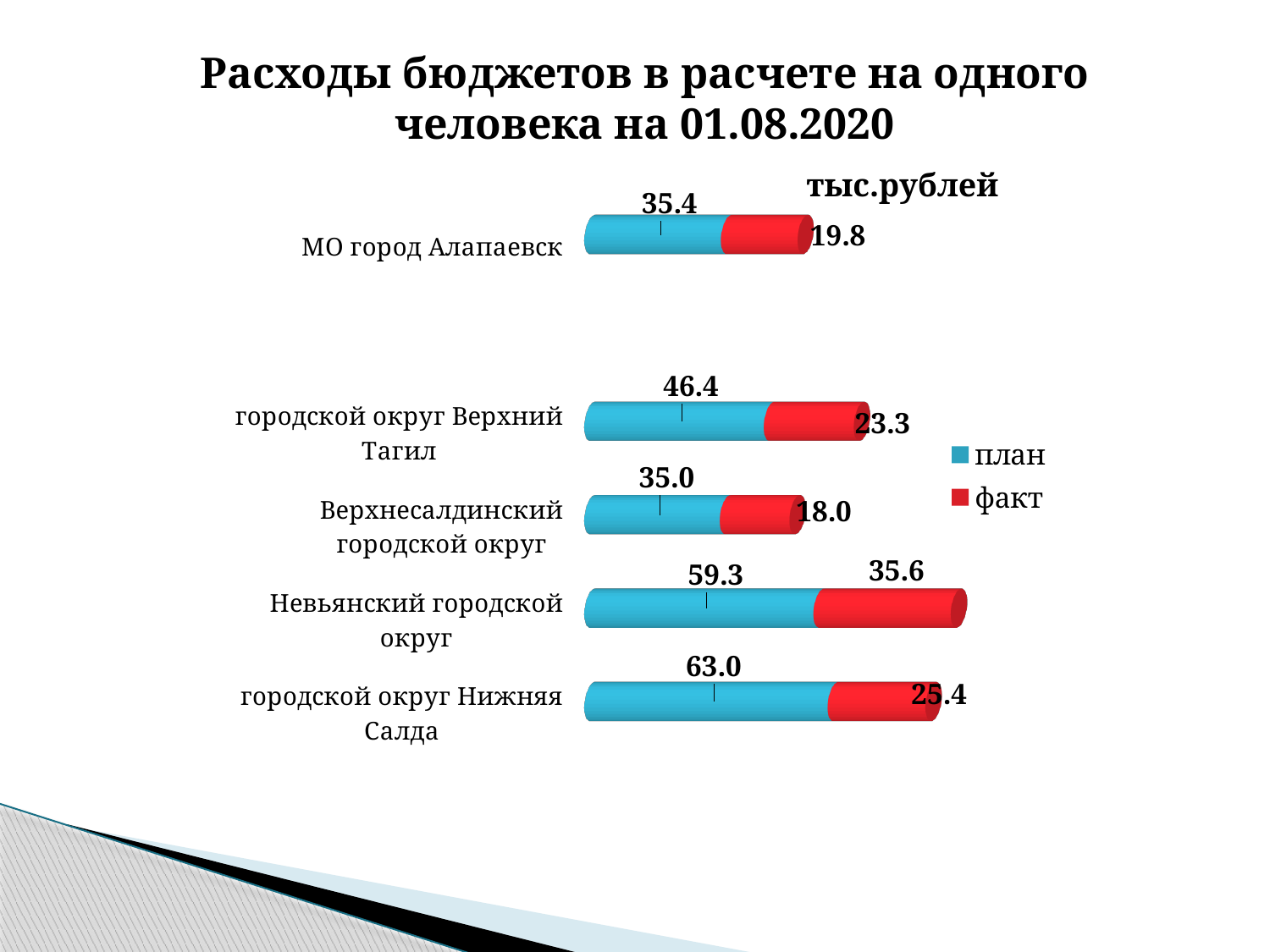
Which category has the lowest факт value? Верхнесалдинский городской округ What is the факт value for городской округ Верхний Тагил? 23.3 Which category has the highest план value? городской округ Нижняя Салда What is the difference between the план and факт values for городской округ Нижняя Салда? 37.6 What is the факт value for МО город Алапаевск? 19.8 What is the план value for Невьянский городской округ? 59.3 What is the план value for Верхнесалдинский городской округ? 35.0 How many series does the legend list? 2 Which is larger: the факт value for Невьянский городской округ or the факт value for городской округ Нижняя Салда? Невьянский городской округ What type of chart is shown on the slide? bar chart How many categories are shown in the chart? 5 Which category has the highest факт value? Невьянский городской округ